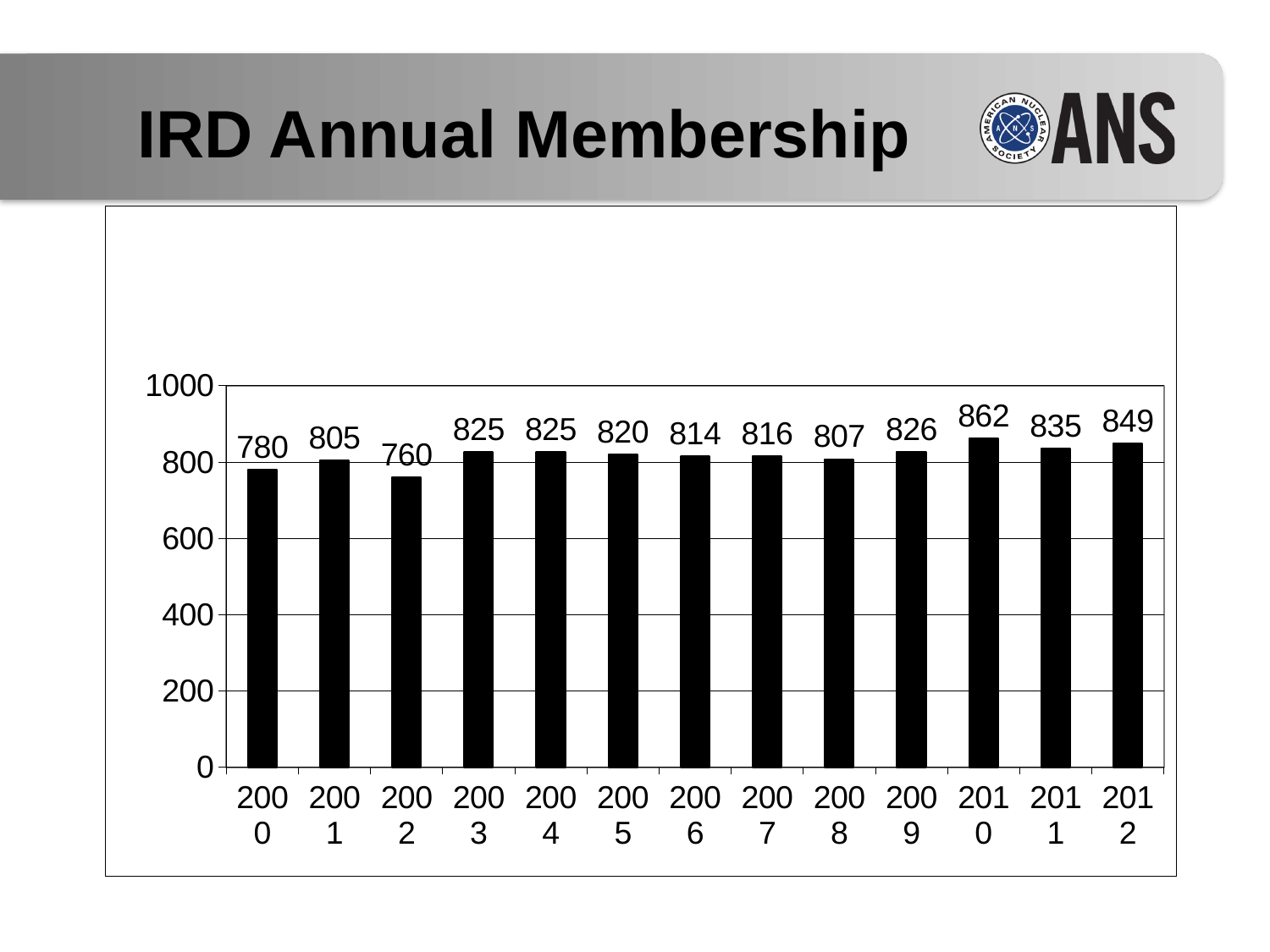
Is the membership value for 2000 greater or less than 800? less What kind of chart is shown on the slide? Bar chart What was the IRD annual membership in 2010? 862 What was the IRD annual membership in 2002? 760 What is the difference in membership between 2010 and 2002? 102 Which year had a larger membership, 2001 or 2008? 2008 How many years are shown on the chart? 13 Which year had the highest IRD annual membership? 2010 What is the difference in membership between 2012 and 2011? 14 Which year had the lowest IRD annual membership? 2002 What is the title of the slide containing the chart? IRD Annual Membership What was the IRD annual membership in 2012? 849